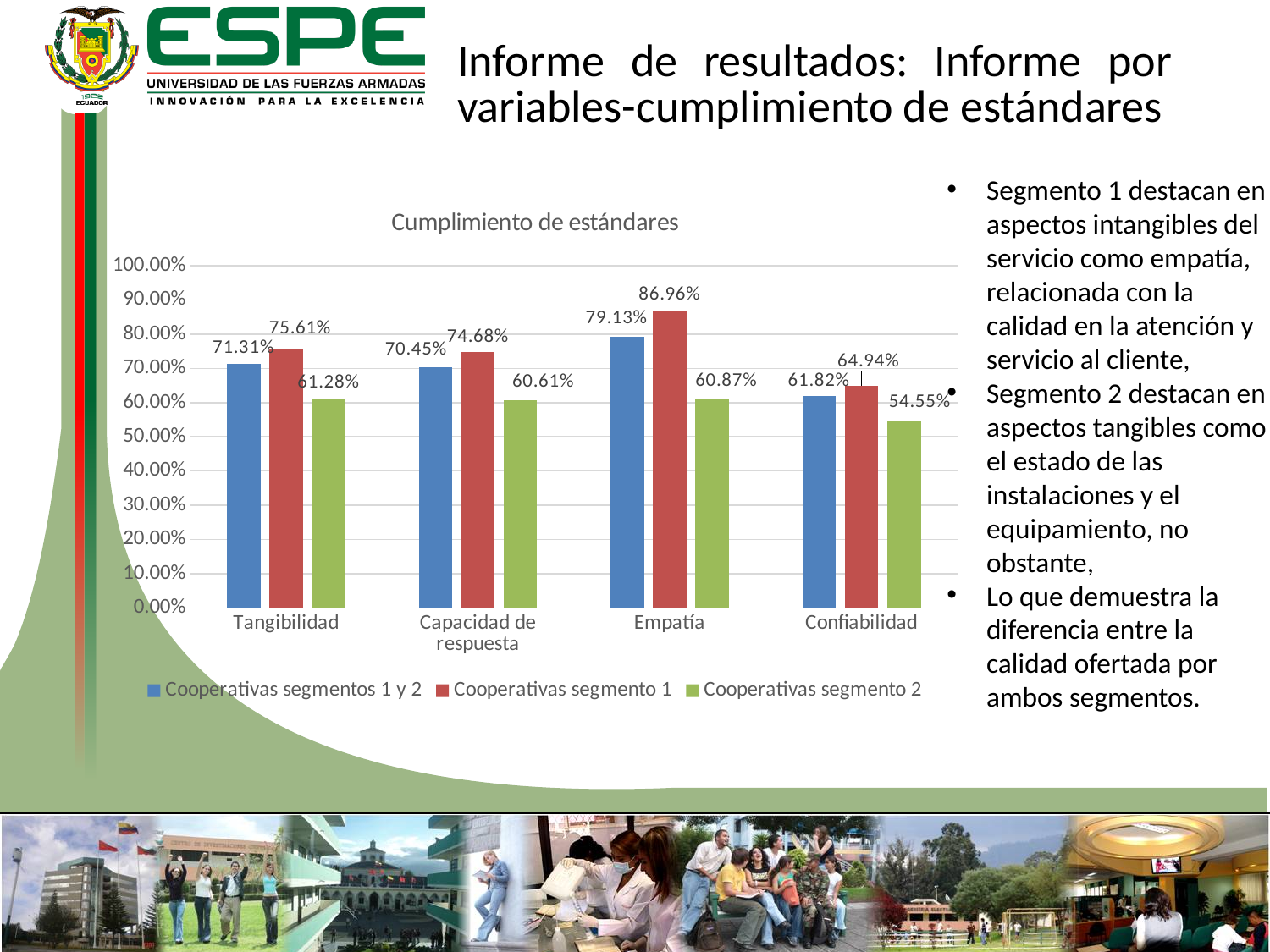
What kind of chart is shown on the slide? Bar chart How many categories are shown on the x axis? 4 What is the title of the chart? Cumplimiento de estándares How many series does the legend list? 3 Which is larger in the Tangibilidad category: Cooperativas segmento 1 or Cooperativas segmento 2? Cooperativas segmento 1 What is the value for Cooperativas segmento 2 in the Confiabilidad category? 54.55% Which category has the lowest value for Cooperativas segmento 2? Confiabilidad What is the value for Cooperativas segmento 1 in the Empatía category? 86.96% Which category has the highest value for Cooperativas segmento 1? Empatía What is the difference between Cooperativas segmento 1 and Cooperativas segmento 2 in the Empatía category? 26.09% Is the value for Cooperativas segmento 1 in the Confiabilidad category greater or less than 70.00%? less What is the value for Cooperativas segmentos 1 y 2 in the Capacidad de respuesta category? 70.45%